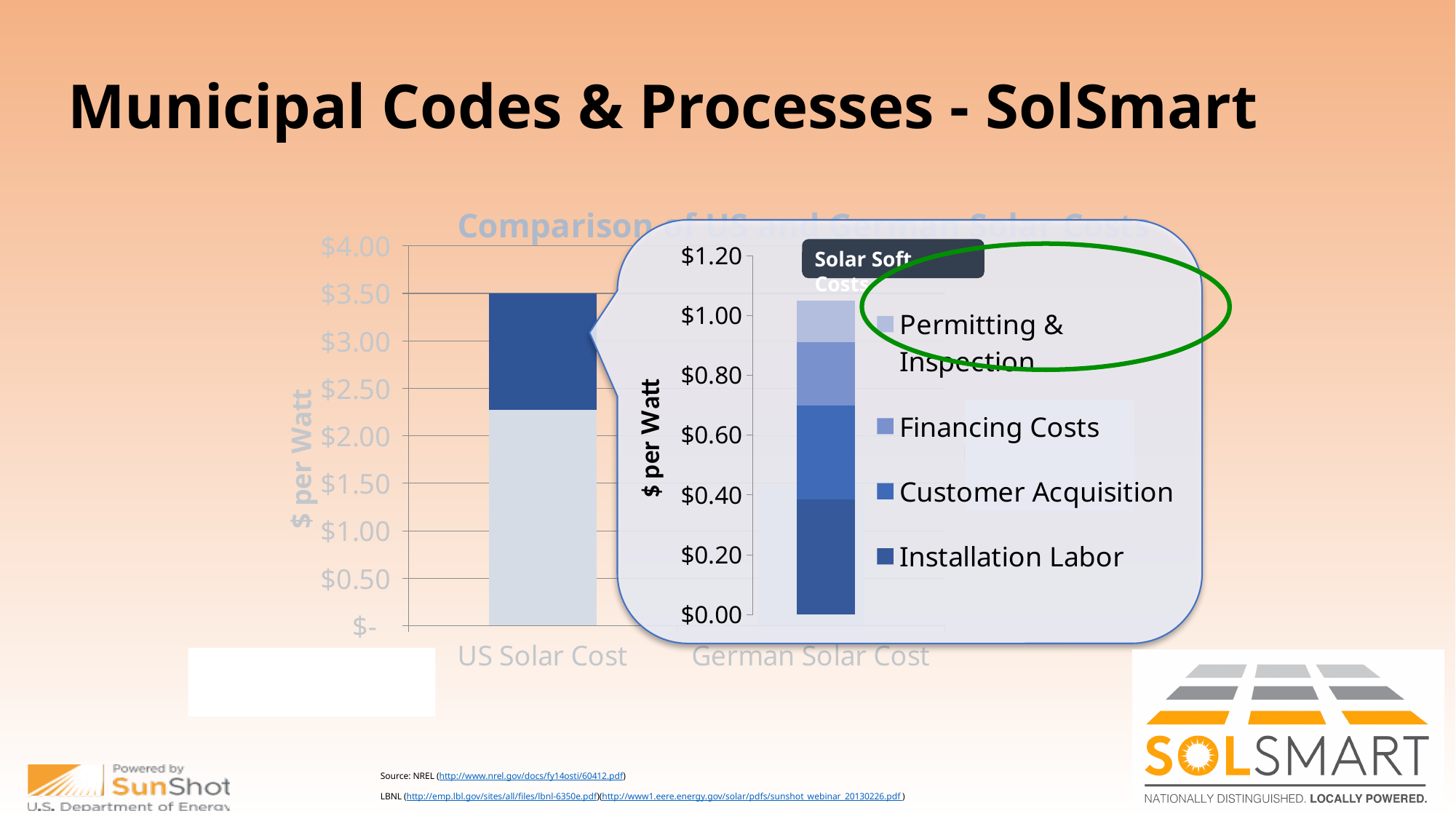
How many categories are shown on the x axis of the 'Comparison of US and German Solar Costs' chart? 2 In the 'Comparison of US and German Solar Costs' chart, is the total US Solar Cost bar greater or less than $3.00? greater In the 'Solar Soft Costs' chart, is the Customer Acquisition segment larger or smaller than the Financing Costs segment? Larger In the 'Solar Soft Costs' chart, which legend entry is circled in green? Permitting & Inspection What kind of chart is the 'Comparison of US and German Solar Costs' chart? Stacked bar chart In the 'Solar Soft Costs' chart, is the Installation Labor segment greater or less than $0.20? greater In the 'Solar Soft Costs' chart, which series is shown at the bottom of the stacked bar? Installation Labor In the 'Solar Soft Costs' chart, which segment of the stacked bar is the largest? Installation Labor In the 'Solar Soft Costs' chart, is the total height of the stacked bar greater or less than $1.00? greater What kind of chart is the 'Solar Soft Costs' chart in the callout? Stacked bar chart How many series does the legend of the 'Solar Soft Costs' chart list? 4 What is the y-axis label of the 'Solar Soft Costs' chart? $ per Watt